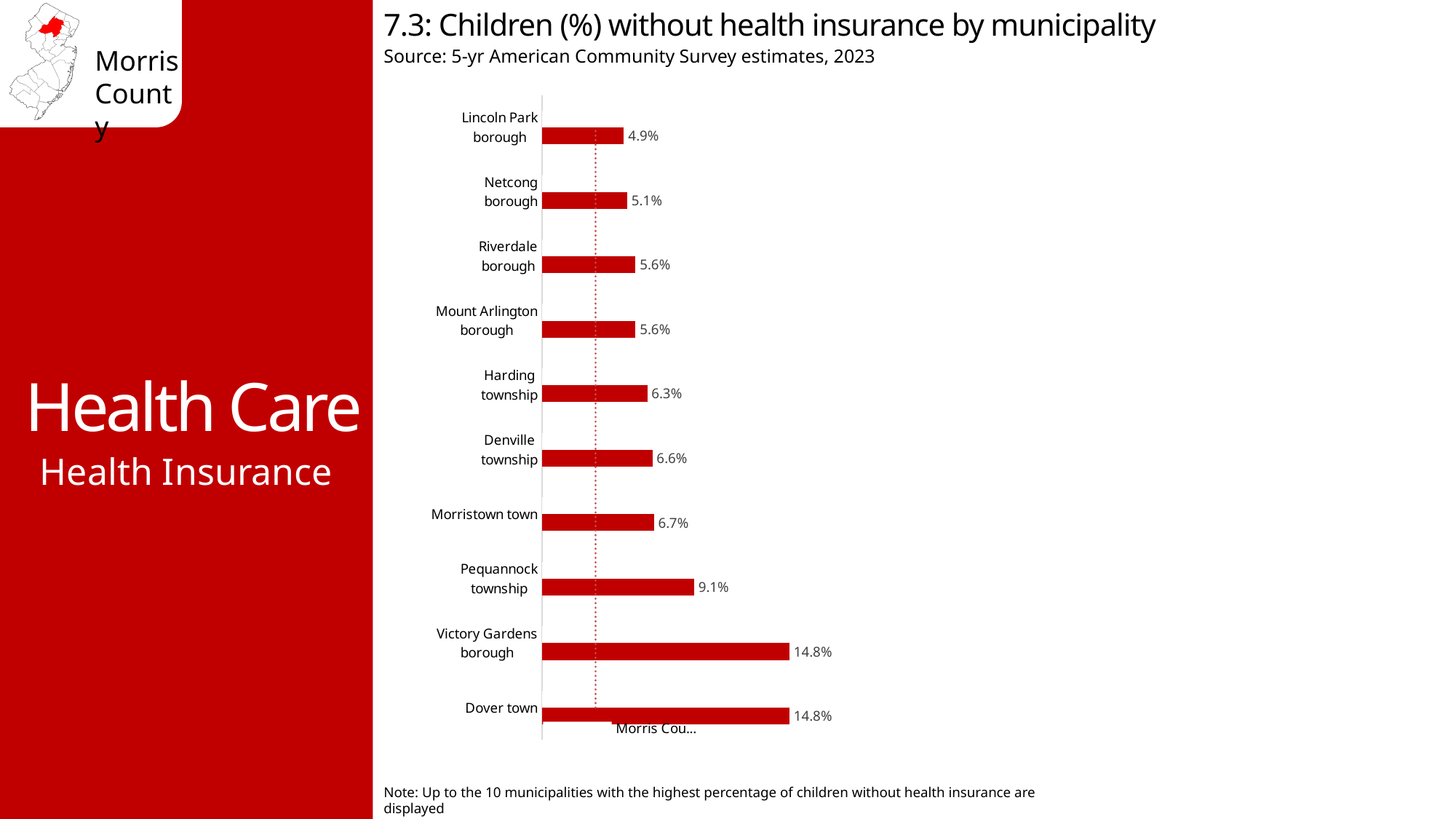
How many municipalities are shown on the chart? 10 What type of chart is used on this slide? Bar chart What is the source of the data shown in the chart? 5-yr American Community Survey estimates, 2023 What percentage is shown for Harding township? 6.3% What is the value for Morristown town? 6.7% Which municipality has the lowest percentage of children without health insurance on the chart? Lincoln Park borough What is the title of the chart? 7.3: Children (%) without health insurance by municipality What is the difference between the values for Denville township and Netcong borough? 1.5% What is the difference between the values for Victory Gardens borough and Pequannock township? 5.7% What is the value shown for Dover town? 14.8% Which has a higher percentage of children without health insurance, Riverdale borough or Morristown town? Morristown town What percentage of children are without health insurance in Pequannock township? 9.1%